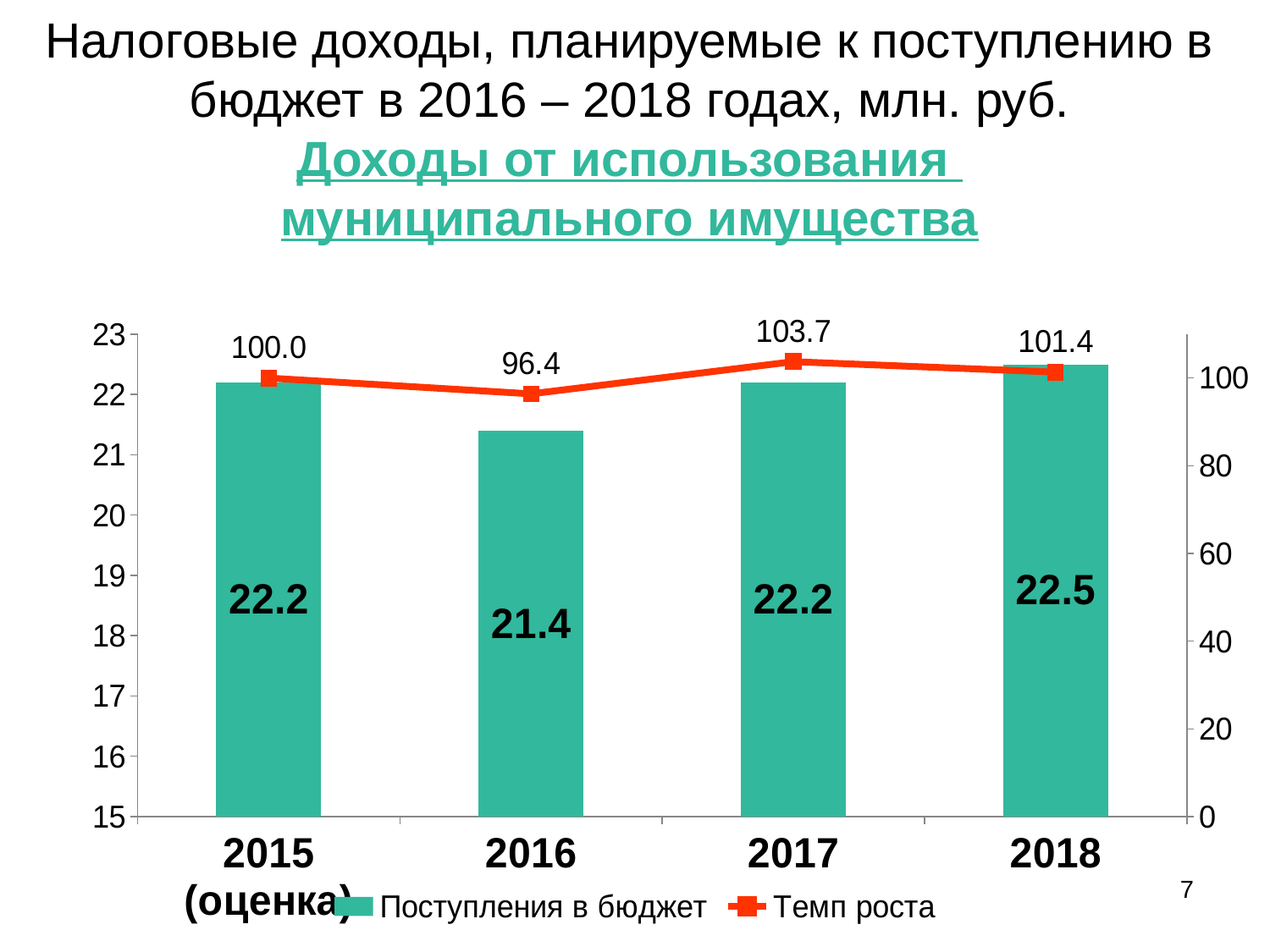
What kind of chart is used for the Поступления в бюджет series? Bar chart What is the value of Поступления в бюджет for 2016? 21.4 Which is larger: Темп роста in 2017 or in 2018? 2017 Which year has the lowest value of Темп роста? 2016 What is the difference between Поступления в бюджет in 2018 and in 2016? 1.1 What is the value of Поступления в бюджет for 2018? 22.5 How many series does the legend list? 2 What is the value of Темп роста for 2015 (оценка)? 100.0 Which year has the highest value of Поступления в бюджет? 2018 What is the value of Темп роста for 2017? 103.7 What colour is the Темп роста line? Red How many years are shown on the x axis? 4